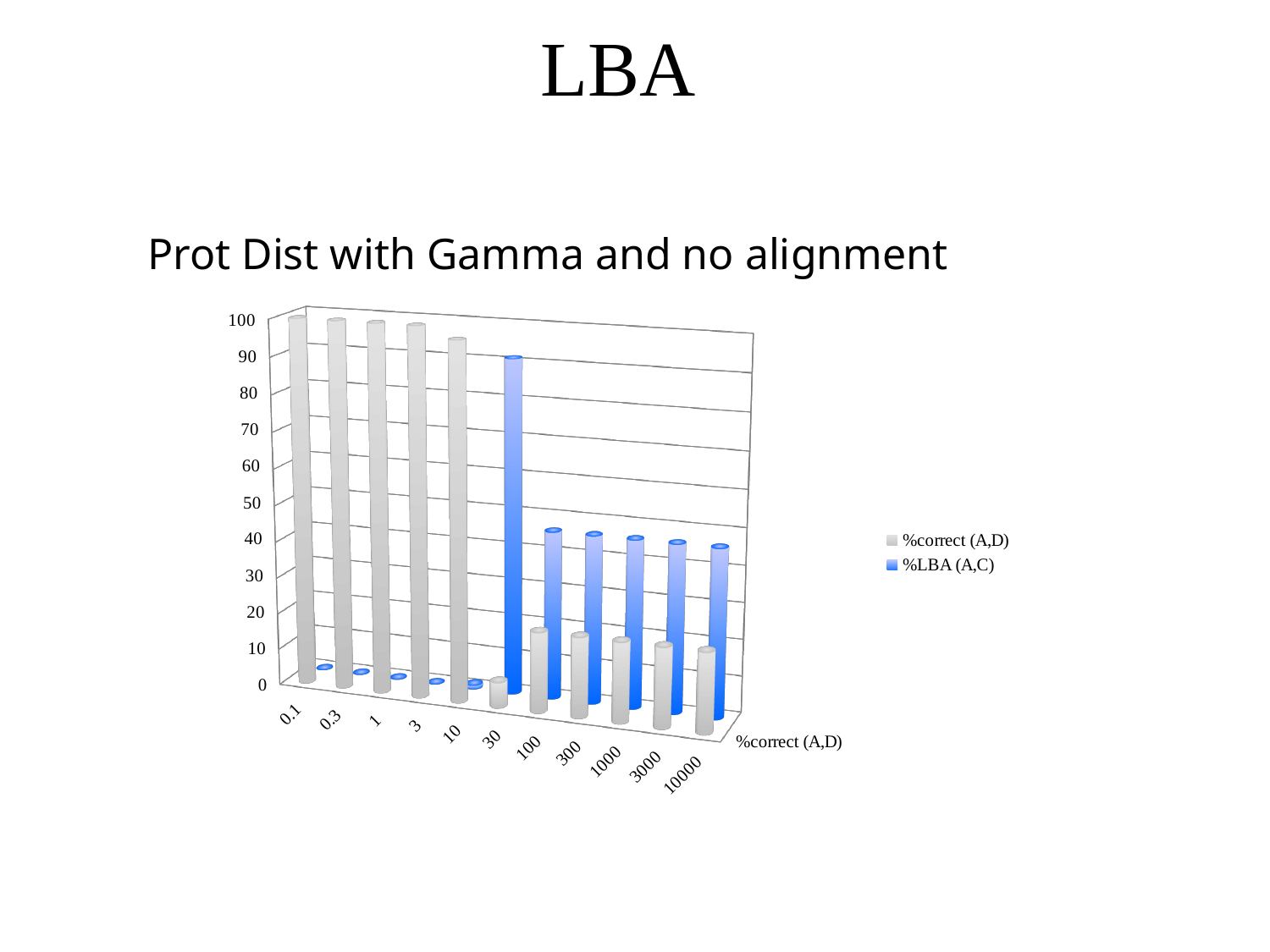
For which category is %correct (A,D) lowest? 30 At category 100, which series has the larger value, %correct (A,D) or %LBA (A,C)? %LBA (A,C) How many series does the legend list? 2 What is the title of the chart? Prot Dist with Gamma and no alignment For which category is %LBA (A,C) highest? 30 What kind of chart is shown on the slide? bar chart Is the value of %correct (A,D) at 0.1 greater or less than 90? greater Is the value of %LBA (A,C) at 100 greater or less than 70? less How many categories are shown on the x axis? 11 Which series is shown in blue? %LBA (A,C) Is the value of %LBA (A,C) at 0.1 greater or less than 10? less